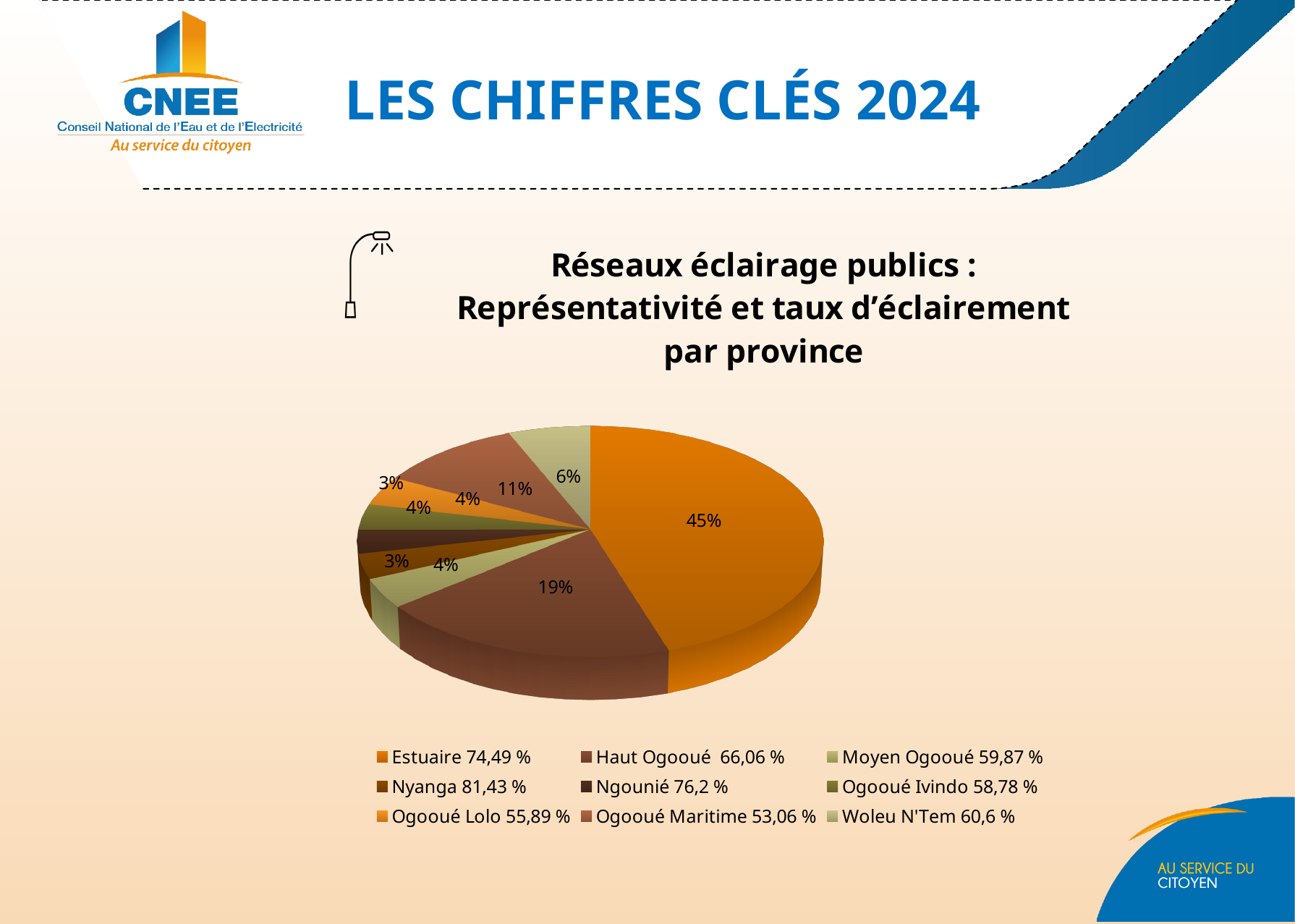
What share of the pie does Woleu N'Tem represent? 6% What lighting rate is given for Ogooué Maritime in the legend? 53,06 % Which province has the largest slice of the pie chart? Estuaire How many provinces (slices) does the pie chart show? 9 What is the difference in percentage points between the Estuaire slice and the Haut Ogooué slice? 26 percentage points What kind of chart is shown on the slide? Pie chart Which province has the highest lighting rate listed in the legend? Nyanga Which province has the lowest lighting rate listed in the legend? Ogooué Maritime What share of the pie does Estuaire represent? 45% What lighting rate (taux d'éclairement) is given for Nyanga in the legend? 81,43 % Which has a higher lighting rate in the legend, Estuaire or Haut Ogooué? Estuaire What share of the pie does Haut Ogooué represent? 19%